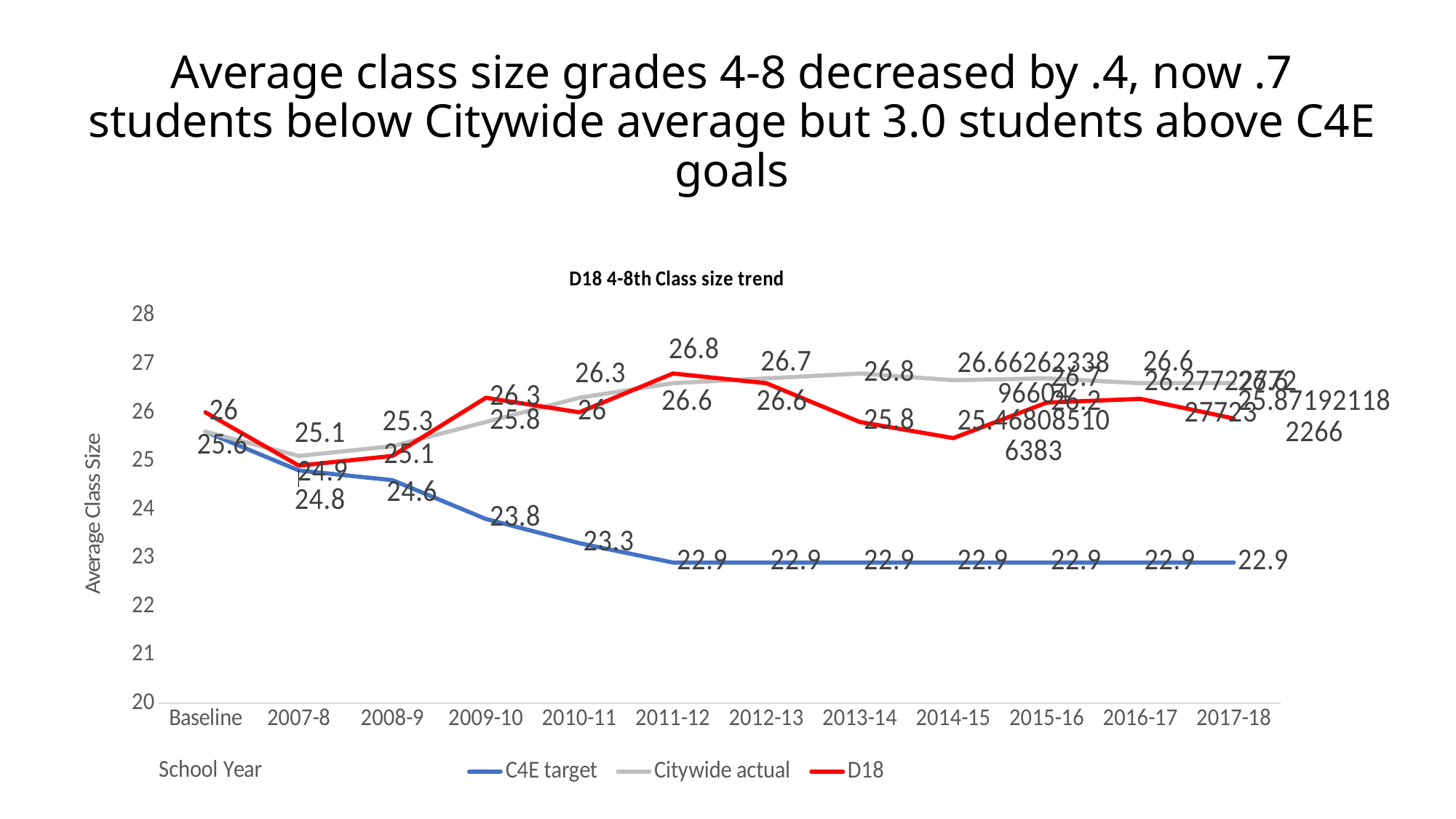
How many school years (categories) are plotted on the x axis? 12 What is the D18 value for 2011-12? 26.8 What is the C4E target value for 2017-18? 22.9 In which school year is the D18 value lowest? 2007-8 Does the C4E target series rise or fall from Baseline to 2011-12? Fall What is the D18 value at Baseline? 26 How many series does the legend list? 3 What is the C4E target value for 2009-10? 23.8 What is the difference between the C4E target at Baseline and in 2017-18? 2.7 Which is larger in 2013-14, the Citywide actual value or the D18 value? Citywide actual What is the Citywide actual value for 2008-9? 25.3 What type of chart is shown on the slide? Line chart